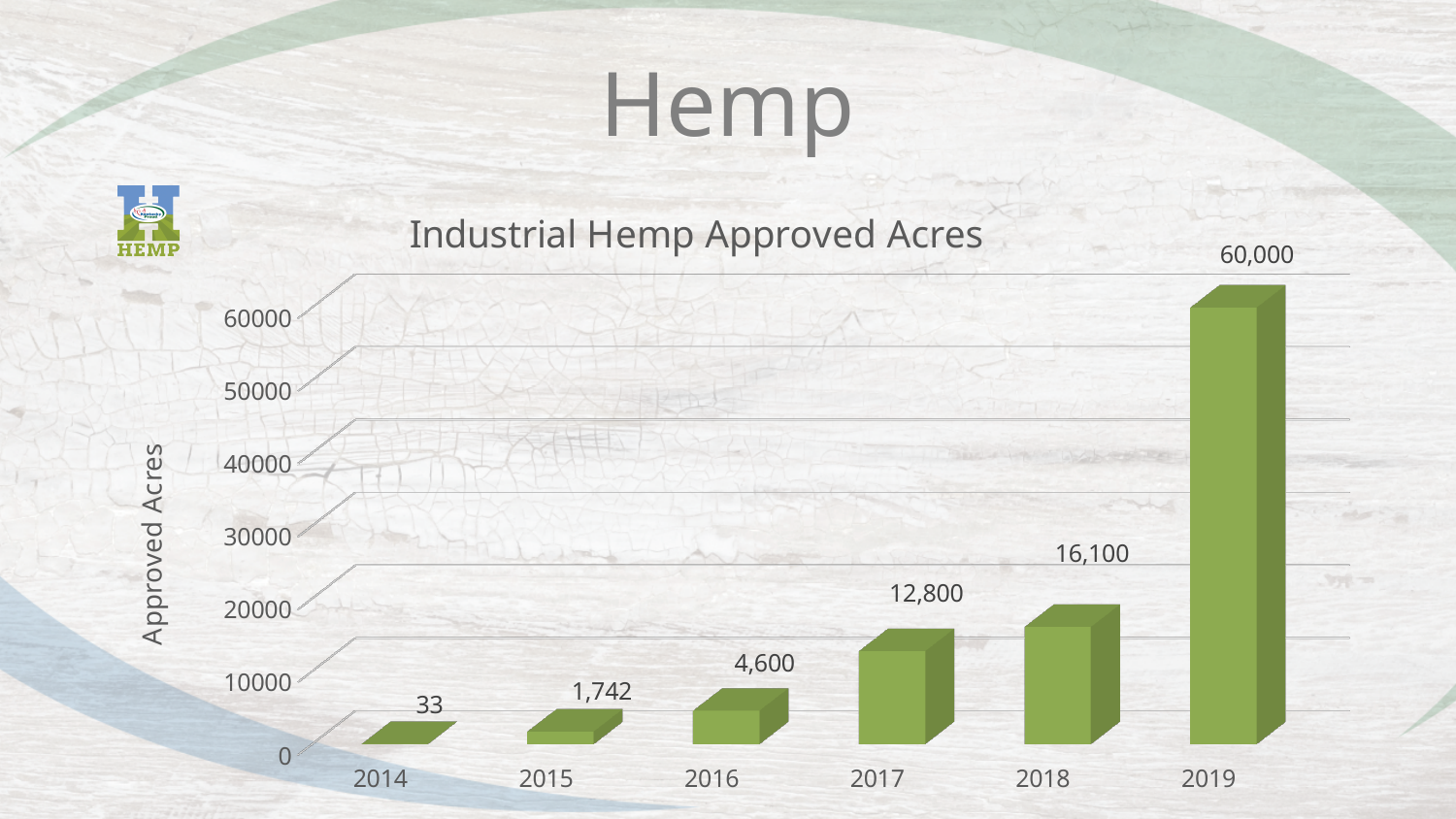
Which year has the lowest approved acres? 2014 Do the approved acres rise or fall from 2014 to 2019? rise Which year has more approved acres, 2016 or 2017? 2017 Is the value for 2018 greater or less than 20000? less What is the value for 2017 in the Industrial Hemp Approved Acres chart? 12,800 Which year has the highest approved acres? 2019 What is the difference in approved acres between 2019 and 2018? 43,900 How many years are shown on the x axis of the chart? 6 What is the value for 2019 in the Industrial Hemp Approved Acres chart? 60,000 What is the difference in approved acres between 2018 and 2017? 3,300 What is the value for 2015 in the Industrial Hemp Approved Acres chart? 1,742 What kind of chart is shown on the slide? bar chart